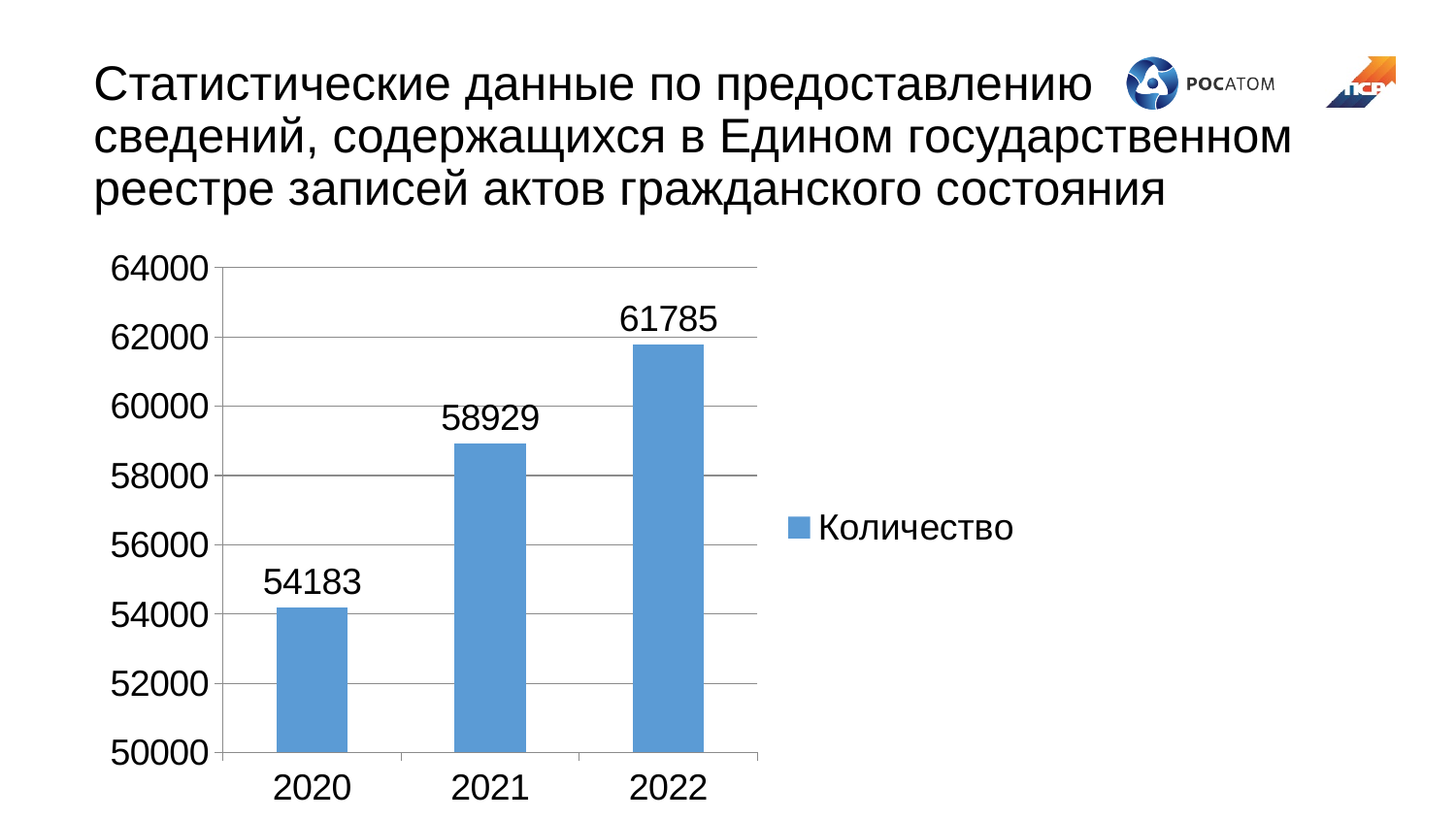
What is the value for 2021? 58929 Which year has the lowest value? 2020 How many years are shown on the x axis? 3 Which is larger, the value for 2021 or the value for 2022? 2022 Is the value for 2021 greater or less than 60000? less Which year has the highest value? 2022 What is the difference between the values for 2022 and 2020? 7602 What is the value for 2022? 61785 What kind of chart is shown on the slide? bar chart What is the value for 2020? 54183 What is the difference between the values for 2021 and 2020? 4746 Do the values rise or fall from 2020 to 2022? rise